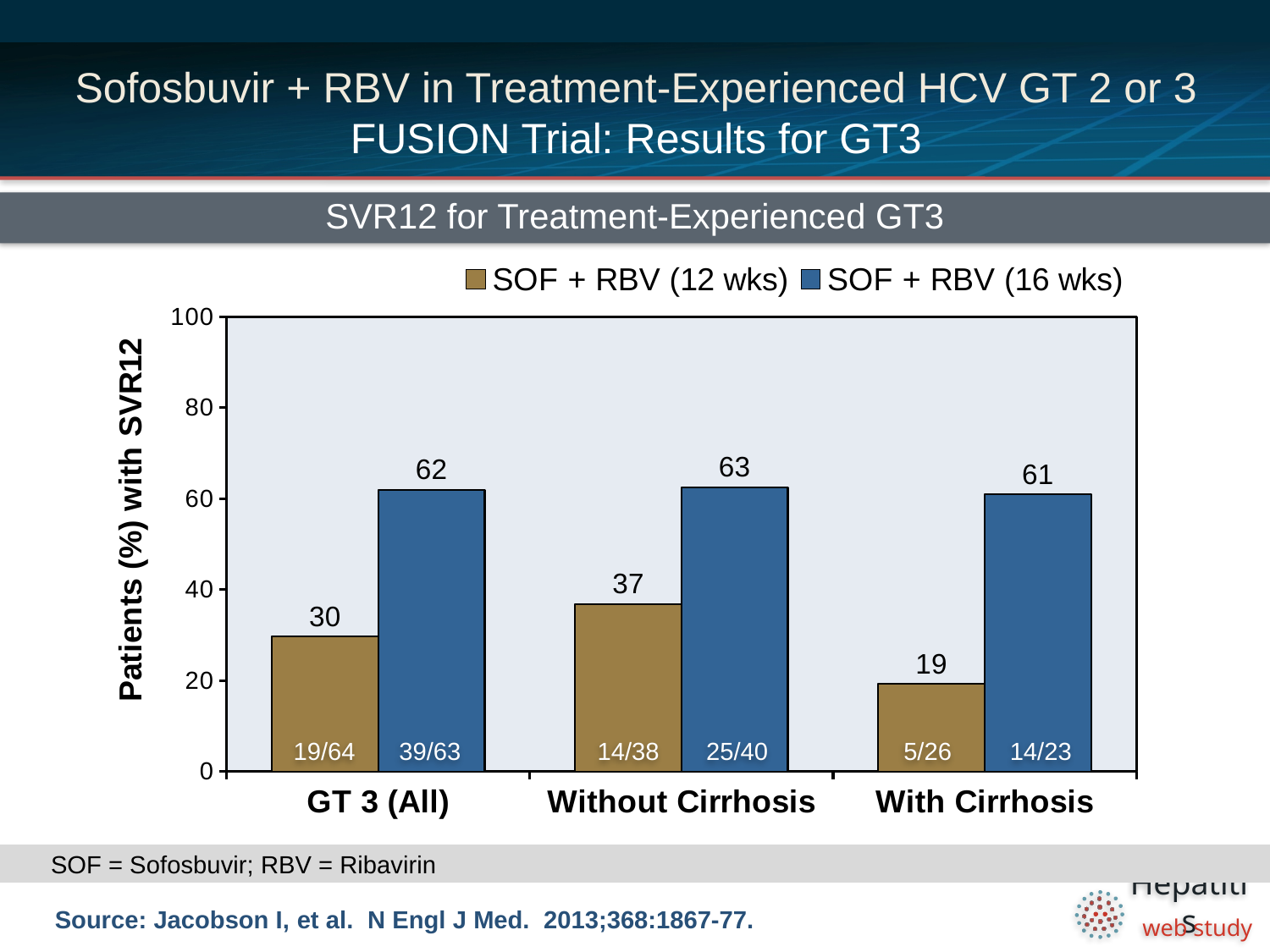
What is the SVR12 rate for SOF + RBV (16 wks) in the With Cirrhosis group? 61 What is the label of the y axis? Patients (%) with SVR12 What is the SVR12 rate for SOF + RBV (12 wks) in the GT 3 (All) group? 30 What kind of chart is shown on the slide? Bar chart What is the difference between the SOF + RBV (16 wks) and SOF + RBV (12 wks) SVR12 rates in the With Cirrhosis group? 42 Which category has the lowest SVR12 rate for SOF + RBV (12 wks)? With Cirrhosis Which is larger in the GT 3 (All) group: the SVR12 rate for SOF + RBV (12 wks) or SOF + RBV (16 wks)? SOF + RBV (16 wks) What fraction of patients is shown inside the SOF + RBV (16 wks) bar for Without Cirrhosis? 25/40 How many categories are shown on the x axis? 3 Which category has the highest SVR12 rate for SOF + RBV (16 wks)? Without Cirrhosis What is the SVR12 rate for SOF + RBV (12 wks) in the Without Cirrhosis group? 37 How many series does the legend list? 2